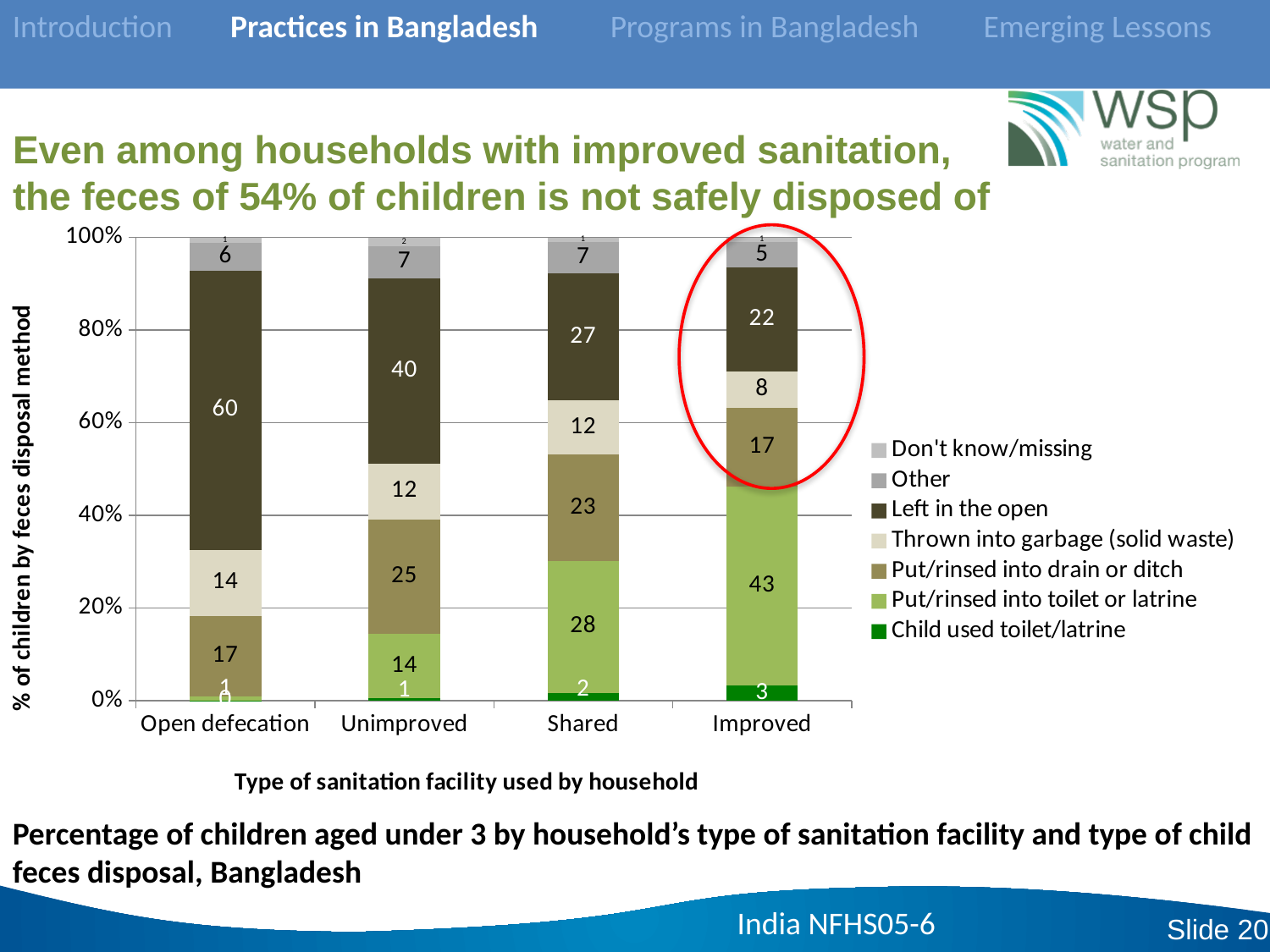
Which type of sanitation facility has the lowest value for 'Left in the open'? Improved What is the title of the x axis? Type of sanitation facility used by household Does the value for 'Put/rinsed into toilet or latrine' rise or fall from Open defecation to Improved along the x axis? Rise Which type of sanitation facility has the highest value for 'Left in the open'? Open defecation Which has the larger value for 'Put/rinsed into drain or ditch', Unimproved or Shared? Unimproved What is the value for 'Thrown into garbage (solid waste)' in the Shared bar? 12 What is the difference between the 'Left in the open' values for Open defecation and Improved? 38 How many series does the chart's legend list? 7 What is the value for 'Put/rinsed into toilet or latrine' in the Improved bar? 43 What kind of chart is shown on the slide? Stacked bar chart What is the value for 'Left in the open' in the Open defecation bar? 60 How many types of sanitation facility are shown along the x axis? 4